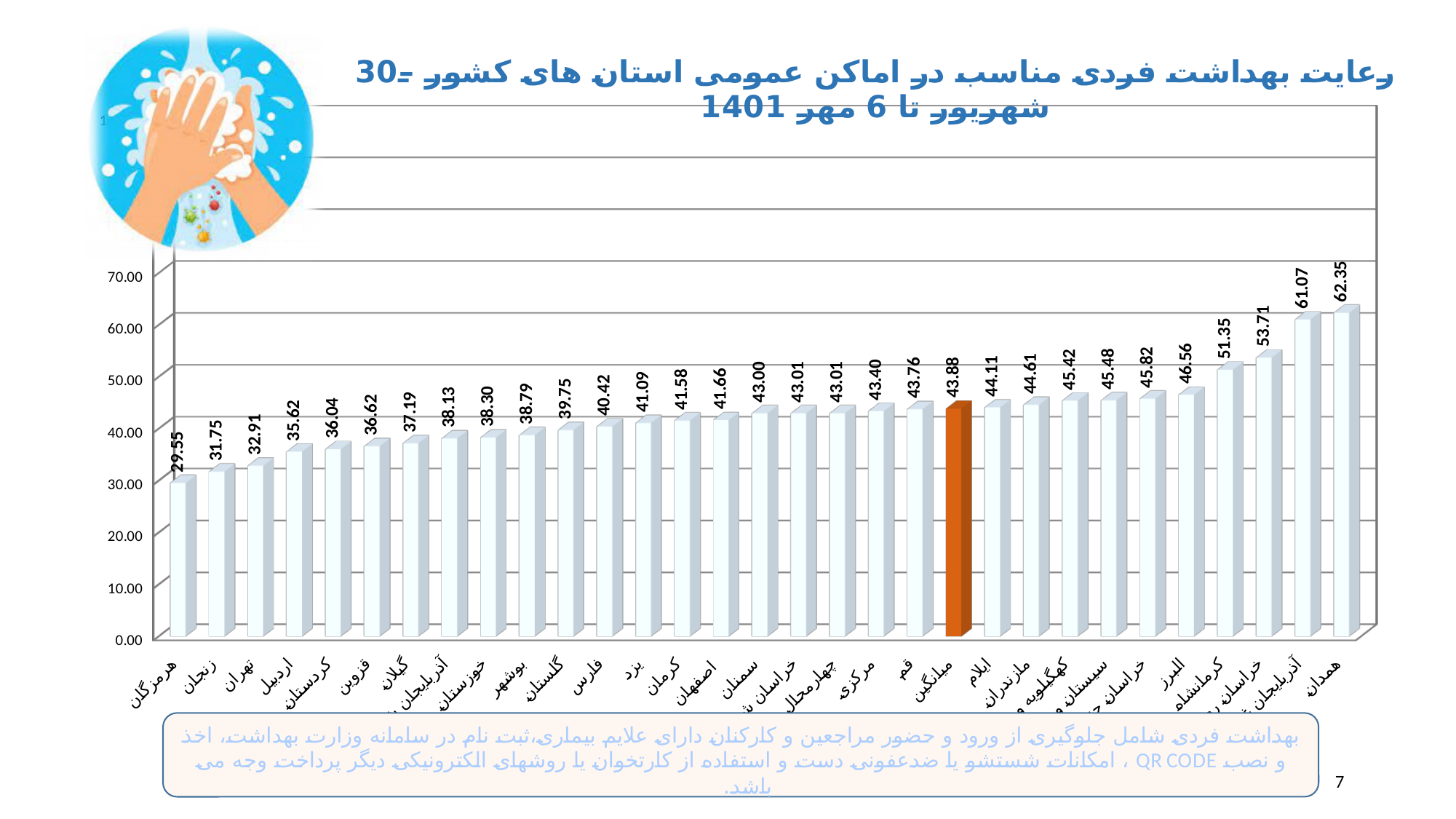
How many bars are plotted in the chart? 31 Do the values rise or fall moving from left to right along the x axis? rise Which province has the highest value? همدان What kind of chart is shown on the slide? bar chart What is the value for همدان? 62.35 Which has a larger value, فارس or گلستان? فارس What is the value shown for the orange bar labelled میانگین? 43.88 Which province has the lowest value? هرمزگان What is the difference between the values for کرمانشاه and البرز? 4.79 Is the value for قم greater or less than 40.00? greater Which bar is coloured differently (orange) from the others? میانگین What is the value for تهران? 32.91